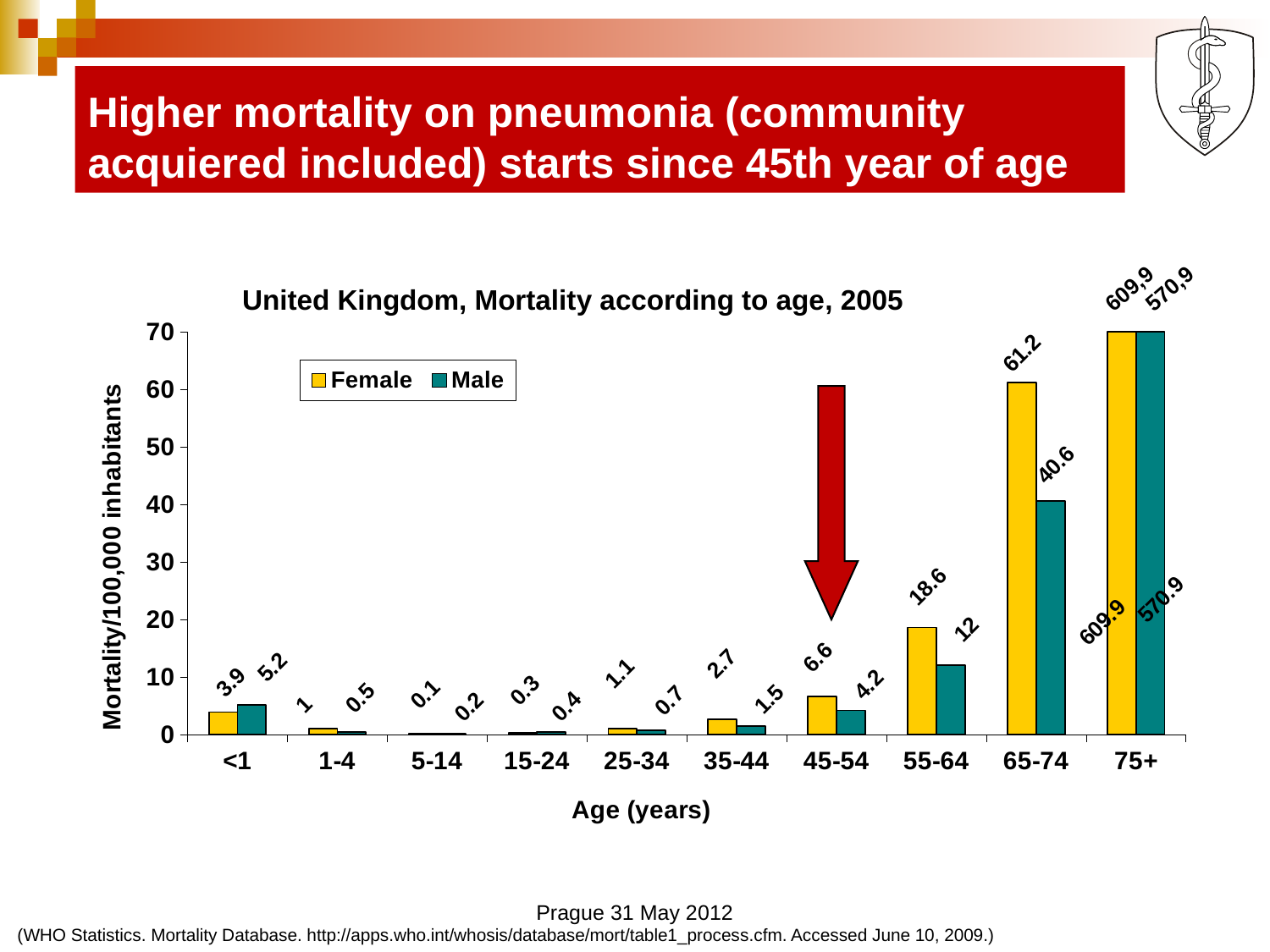
How many age categories are shown on the x axis? 10 What is the Male mortality value for the 55-64 age group? 12 What is the Female mortality value for the 65-74 age group? 61.2 What type of chart is shown on the slide? bar chart Do the Female values generally rise or fall from the 35-44 age group to the 75+ age group? rise What is the chart's title? United Kingdom, Mortality according to age, 2005 How many series does the legend list? 2 Which age group has the highest Male mortality value? 75+ Which age group has the lowest Female mortality value? 5-14 What is the Female mortality value for the 75+ age group? 609,9 What is the difference between the Female and Male values for the 65-74 age group? 20.6 For the <1 age group, which is larger, the Female or the Male value? Male